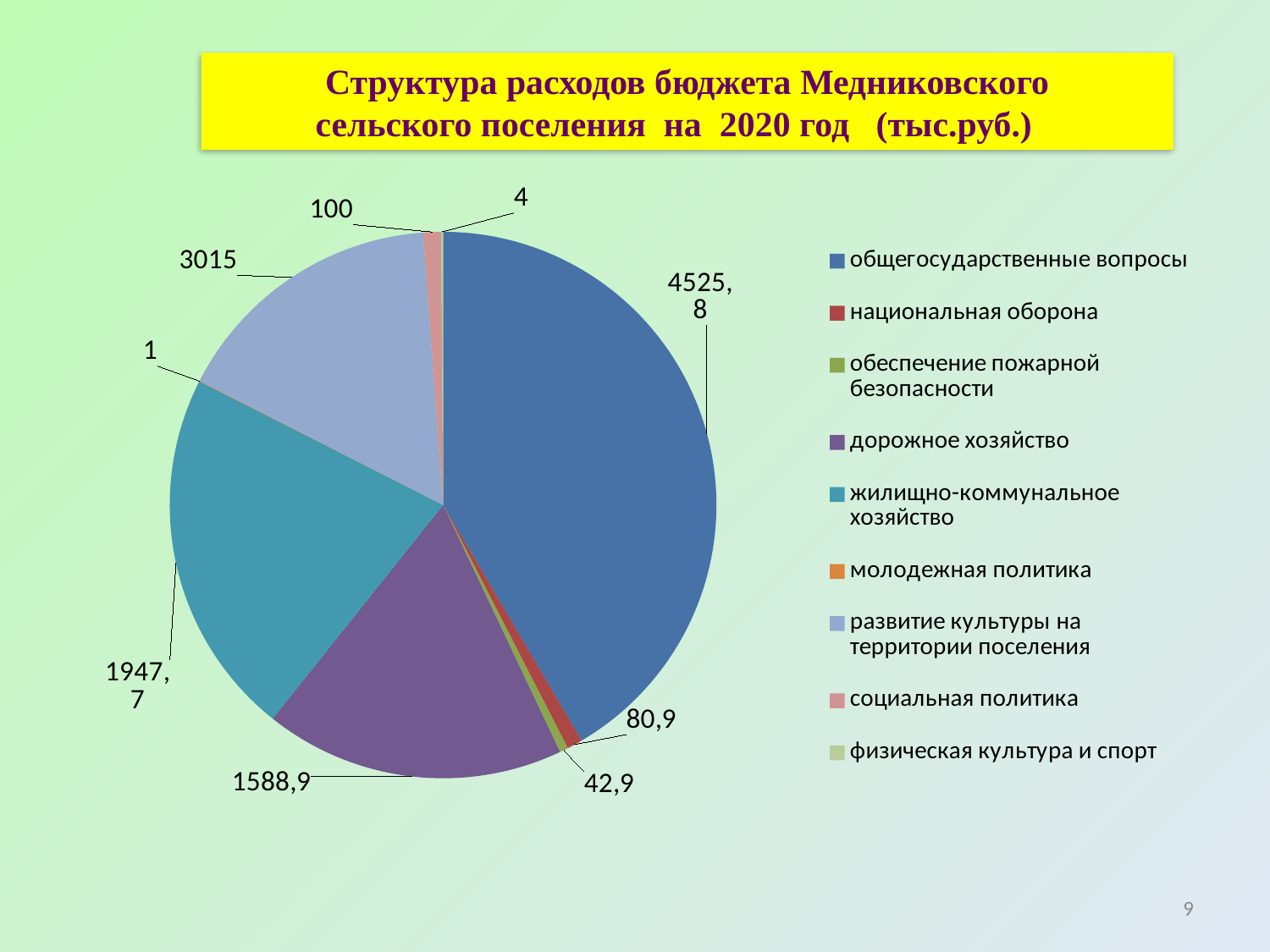
Which is larger: дорожное хозяйство or жилищно-коммунальное хозяйство? жилищно-коммунальное хозяйство Which category has the largest slice of the pie? общегосударственные вопросы Which category has the smallest value in the pie chart? молодежная политика What is the value for развитие культуры на территории поселения? 3015 What is the difference between the values for развитие культуры на территории поселения and жилищно-коммунальное хозяйство? 1067,3 What is the value for физическая культура и спорт? 4 What year does the chart title say the budget expenditure structure is for? 2020 What is the value for социальная политика? 100 What is the value for дорожное хозяйство? 1588,9 What kind of chart is shown on the slide? pie chart How many categories does the legend of the pie chart list? 9 What is the value for национальная оборона? 80,9